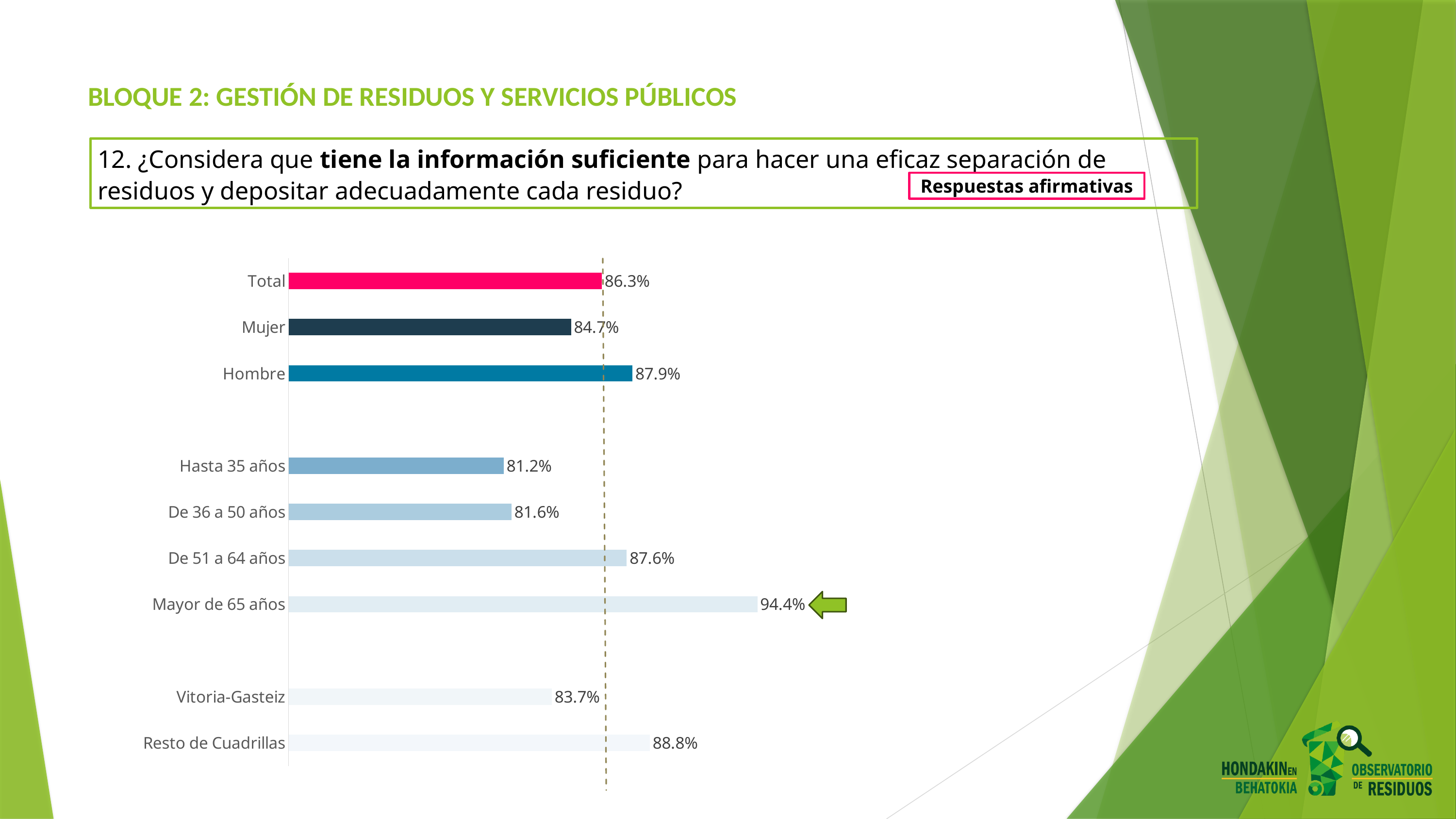
Which category has the lowest value? Hasta 35 años What is the difference between the values for Hombre and Mujer? 3.2% How many categories are plotted in the chart? 9 Which category has the highest value? Mayor de 65 años What is the value for Resto de Cuadrillas? 88.8% Which is larger, the value for De 51 a 64 años or the value for De 36 a 50 años? De 51 a 64 años What is the value for Mayor de 65 años? 94.4% What is the value for Mujer? 84.7% What kind of chart is shown on the slide? Bar chart What is the difference between the values for Resto de Cuadrillas and Vitoria-Gasteiz? 5.1% What is the value for Total? 86.3% What is the value for Hombre? 87.9%